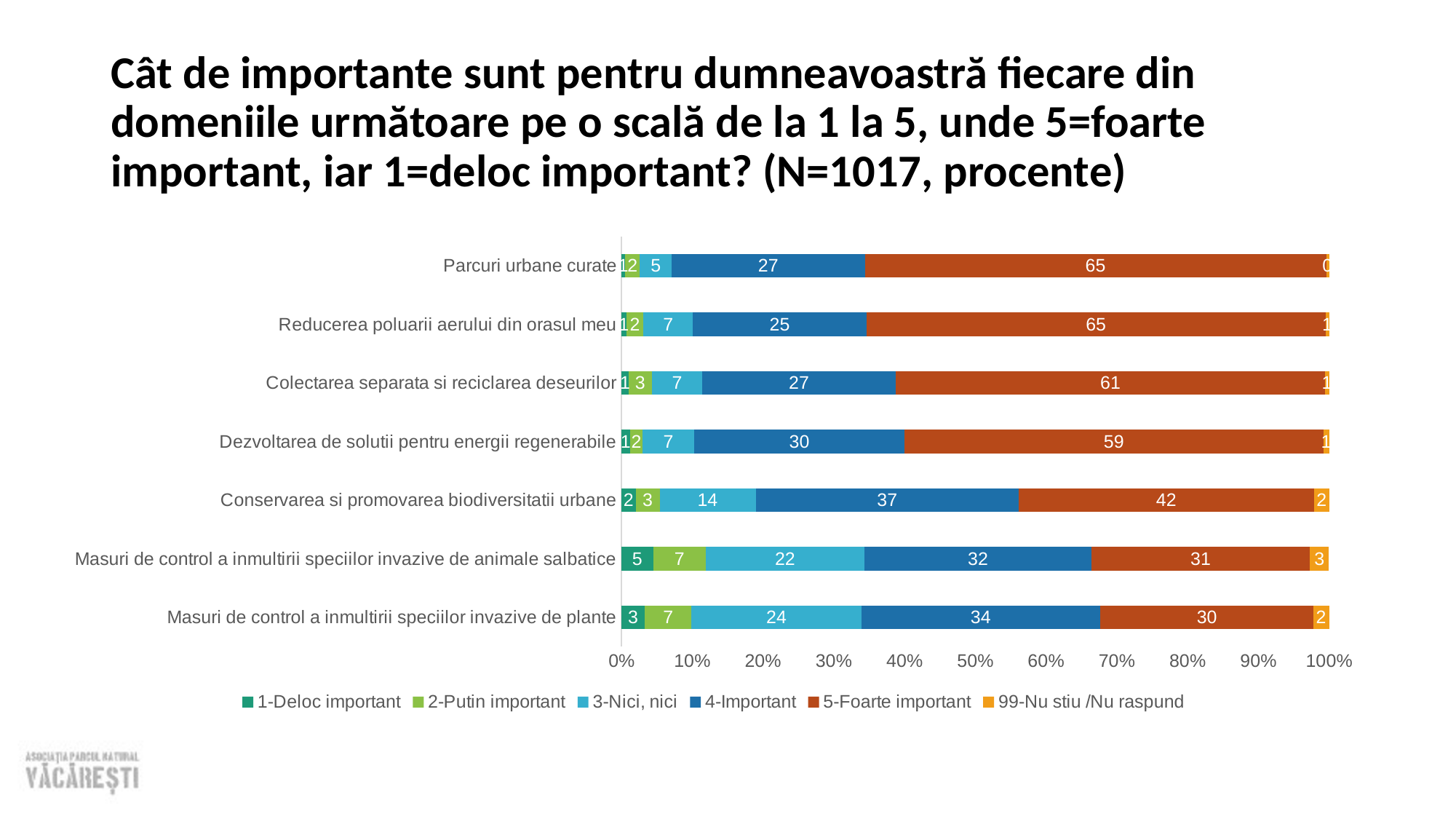
What is the value for 3-Nici, nici for 'Masuri de control a inmultirii speciilor invazive de plante'? 24 What is the total of the stacked bar for 'Parcuri urbane curate'? 100 What kind of chart is shown on the slide? Stacked bar chart How many series does the legend list? 6 What is the difference between the 5-Foarte important values for 'Colectarea separata si reciclarea deseurilor' and 'Conservarea si promovarea biodiversitatii urbane'? 19 Which category has the lowest value for 5-Foarte important? Masuri de control a inmultirii speciilor invazive de plante Which category has the highest value for 1-Deloc important? Masuri de control a inmultirii speciilor invazive de animale salbatice How many categories are shown on the chart? 7 What is the value for 4-Important for 'Conservarea si promovarea biodiversitatii urbane'? 37 What percentage of respondents rated 'Parcuri urbane curate' as 5-Foarte important? 65 Which is larger: the 4-Important value for 'Dezvoltarea de solutii pentru energii regenerabile' or for 'Reducerea poluarii aerului din orasul meu'? Dezvoltarea de solutii pentru energii regenerabile Which category has the highest value for 4-Important? Conservarea si promovarea biodiversitatii urbane